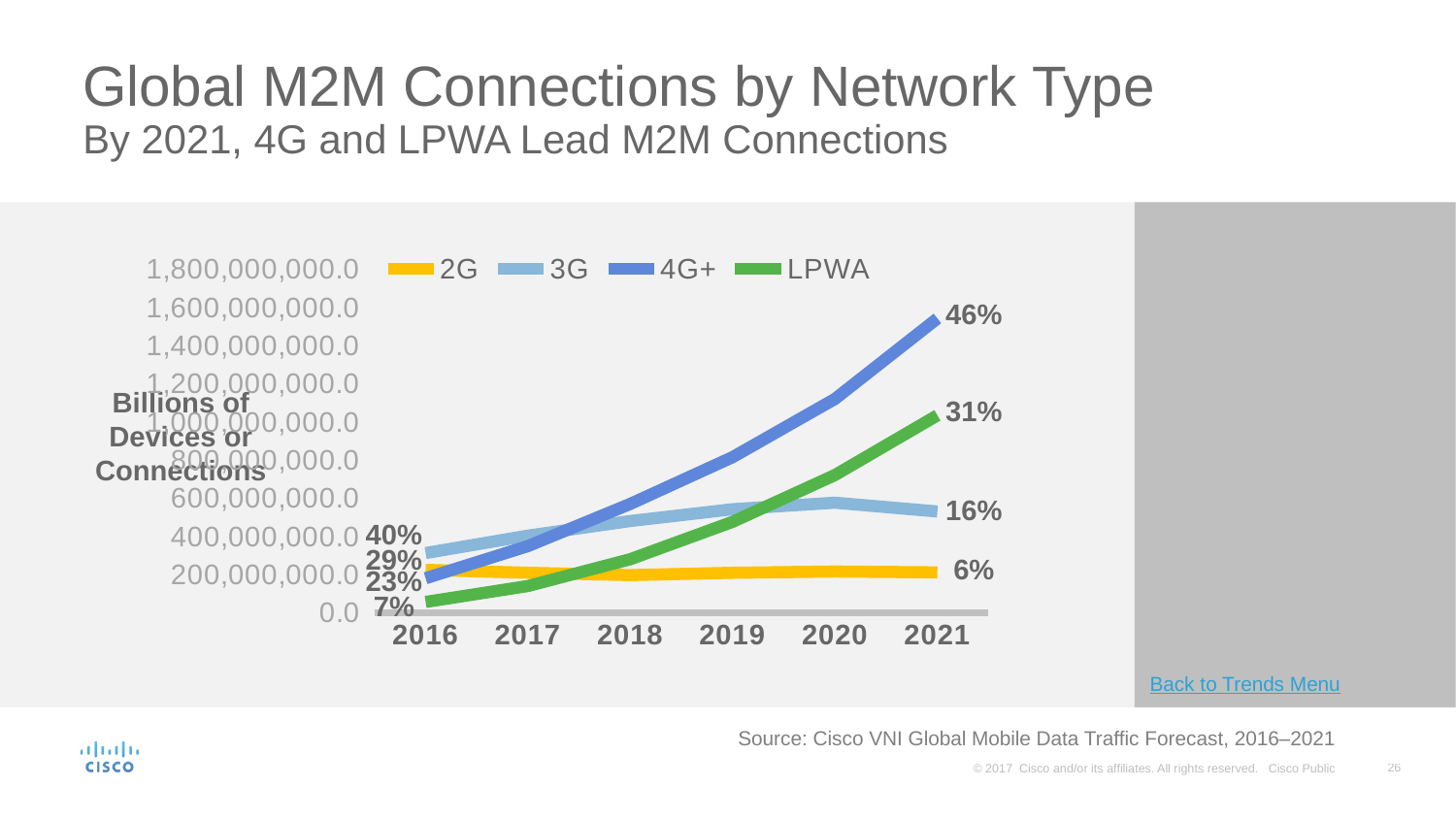
What percentage label is shown for 4G+ at 2021? 46% Which network type has the highest number of connections in 2016? 3G Is the value for 2G in 2021 greater or less than 400,000,000.0? less Which network type has the lowest number of connections in 2021? 2G What percentage label is shown for LPWA at 2021? 31% What percentage label is shown for 2G at 2021? 6% How many series does the legend list? 4 Do 4G+ connections rise or fall from 2016 to 2021? rise Which network type has the highest number of connections in 2021? 4G+ How many years are shown on the x axis? 6 What kind of chart is shown on the slide? line chart Is the value for 4G+ in 2021 greater or less than 1,400,000,000.0? greater